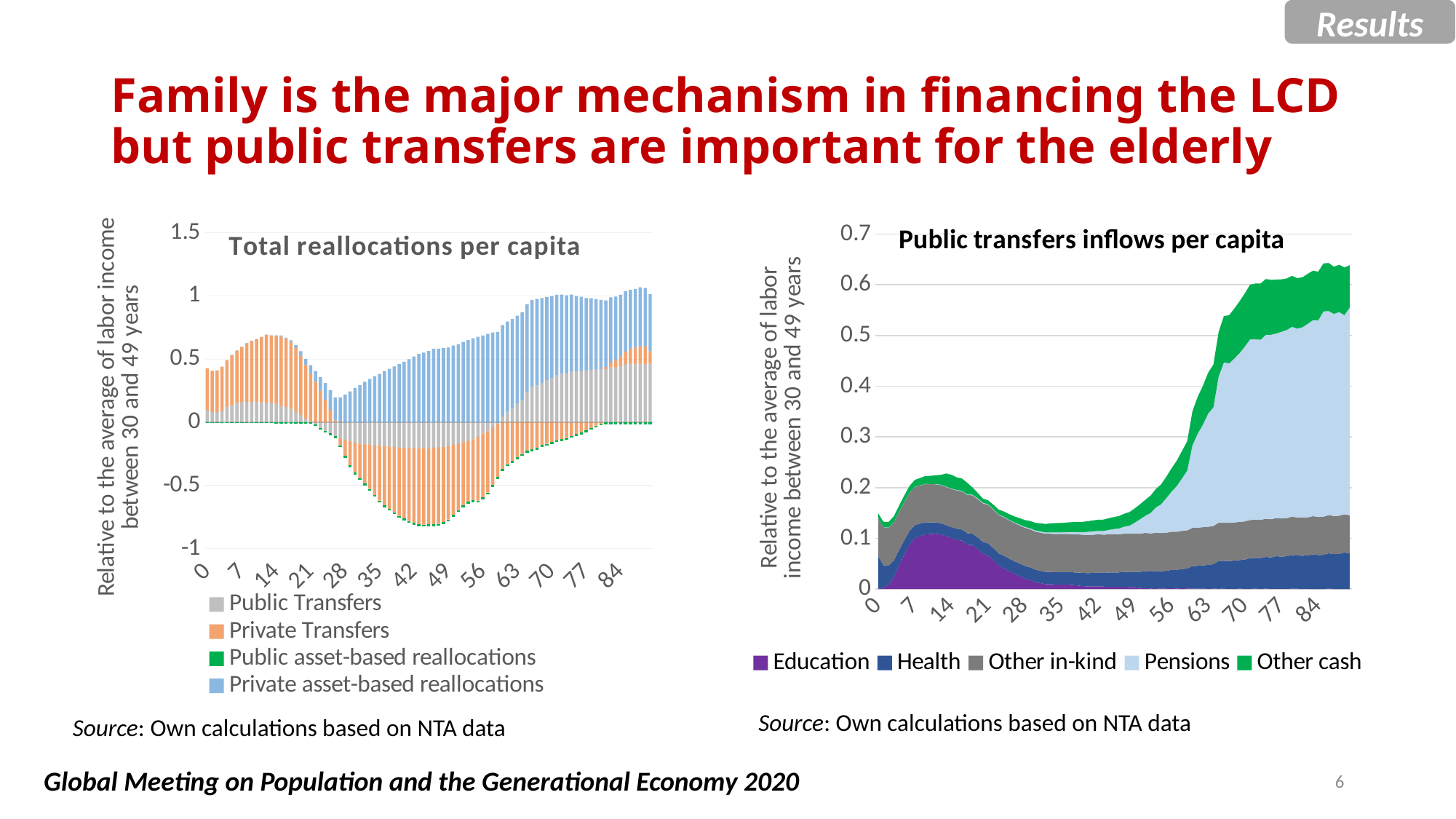
On the right chart, is the total public transfers inflow at age 84 greater or less than 0.5? greater On the left chart, which series is shown in orange? Private Transfers What kind of chart is the left chart titled 'Total reallocations per capita'? Stacked bar chart On the right chart, is the total public transfers inflow at age 35 greater or less than 0.2? less On the left chart, how many series does the legend list? 4 On the left chart, is the top of the positive stacked bar at age 70 greater or less than 0.5? greater On the right chart, how many series does the legend list? 5 On the right chart, does the Education area rise or fall as age increases from 14 to 35? falls On the right chart, which series is shown in green? Other cash On the right chart, does the Pensions area rise or fall as age increases from 56 to 84? rises What kind of chart is the right chart titled 'Public transfers inflows per capita'? Stacked area chart